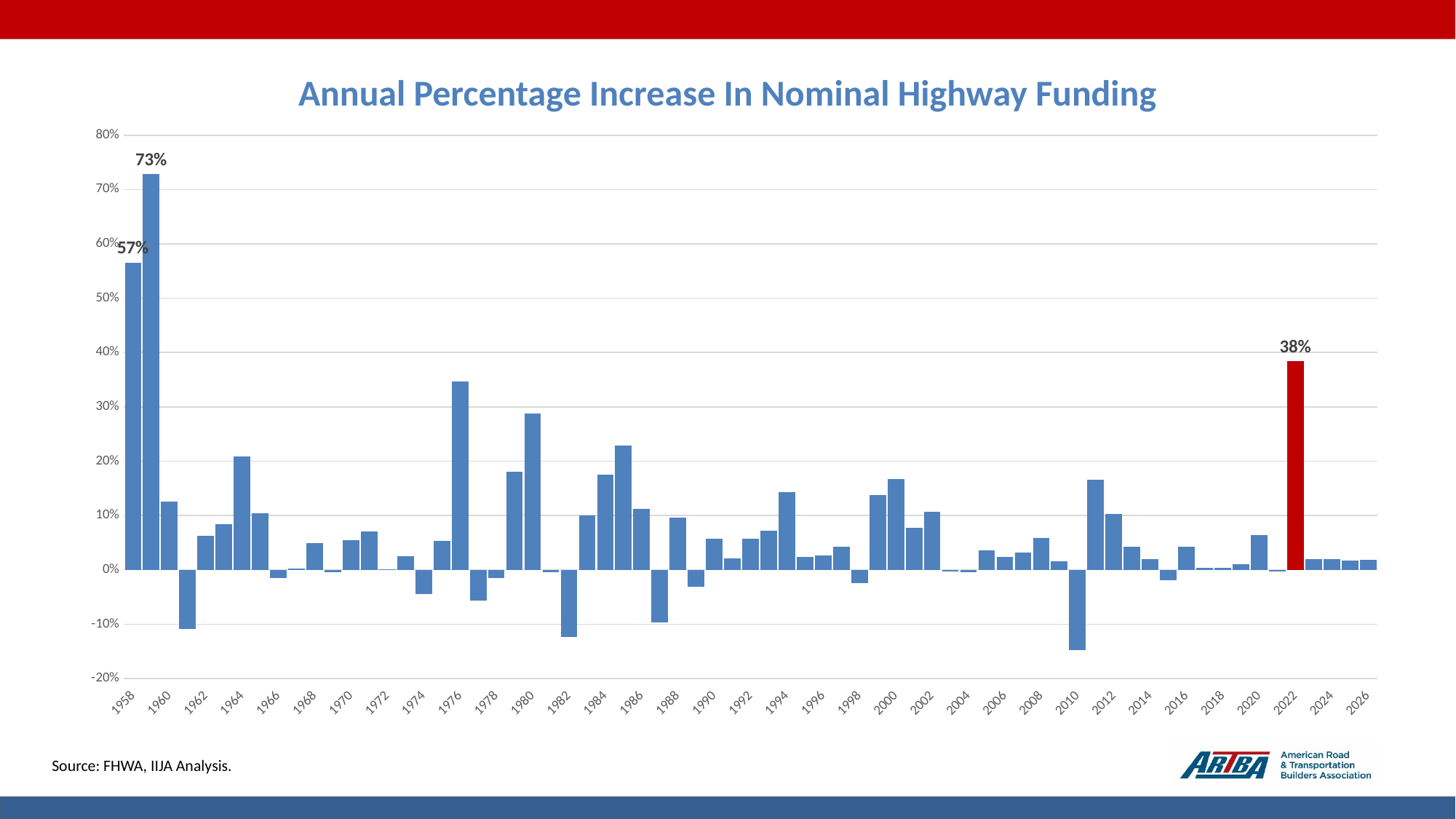
What is the annual percentage increase shown for 1958? 57% Which year has the lowest (most negative) value on the chart? 2010 Is the value for 1976 greater or less than 30%? greater Which year's bar is highlighted in red? 2022 What kind of chart is shown on the slide? bar chart Which year has the larger value, 1976 or 1980? 1976 Is the value for 2010 greater or less than -10%? less What is the annual percentage increase shown for 2022? 38% What is the title of the chart? Annual Percentage Increase In Nominal Highway Funding Is the value for 2000 greater or less than 10%? greater What is the difference between the highest labeled value (73%) and the value for 2022 (38%)? 35% What is the highest annual percentage increase shown on the chart? 73%